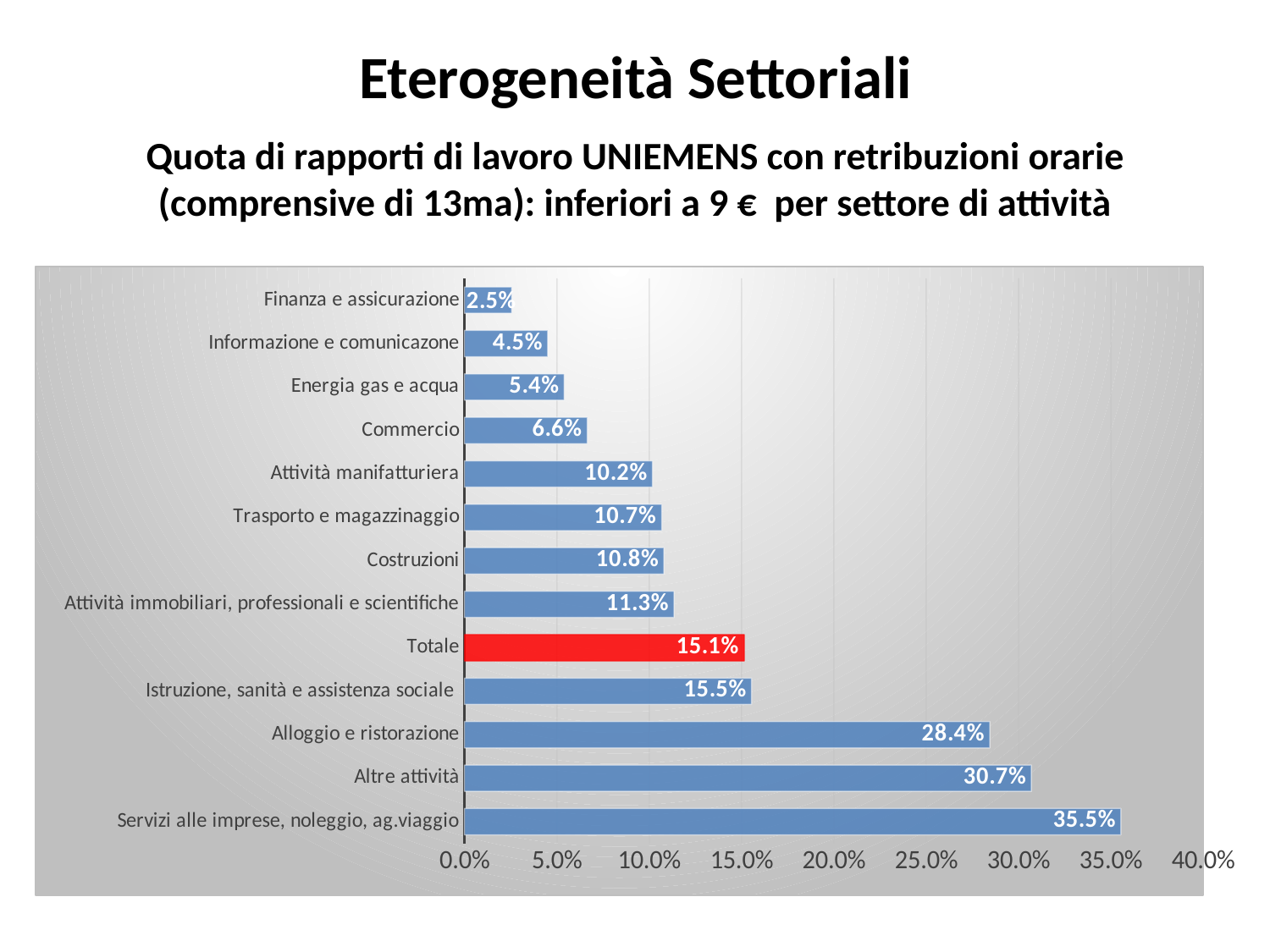
What is the value for Alloggio e ristorazione? 28.4% Which bar is coloured red? Totale What is the difference between the values for Altre attività and Alloggio e ristorazione? 2.3% Which category has the lowest value? Finanza e assicurazione Which category has the highest value? Servizi alle imprese, noleggio, ag.viaggio What is the value for Totale? 15.1% Which is larger, the value for Costruzioni or the value for Attività manifatturiera? Costruzioni What is the value for Commercio? 6.6% What kind of chart is shown on the slide? bar chart Is the value for Istruzione, sanità e assistenza sociale greater or less than 15.0%? greater How many categories are shown in the chart? 13 What is the difference between the values for Servizi alle imprese, noleggio, ag.viaggio and Totale? 20.4%